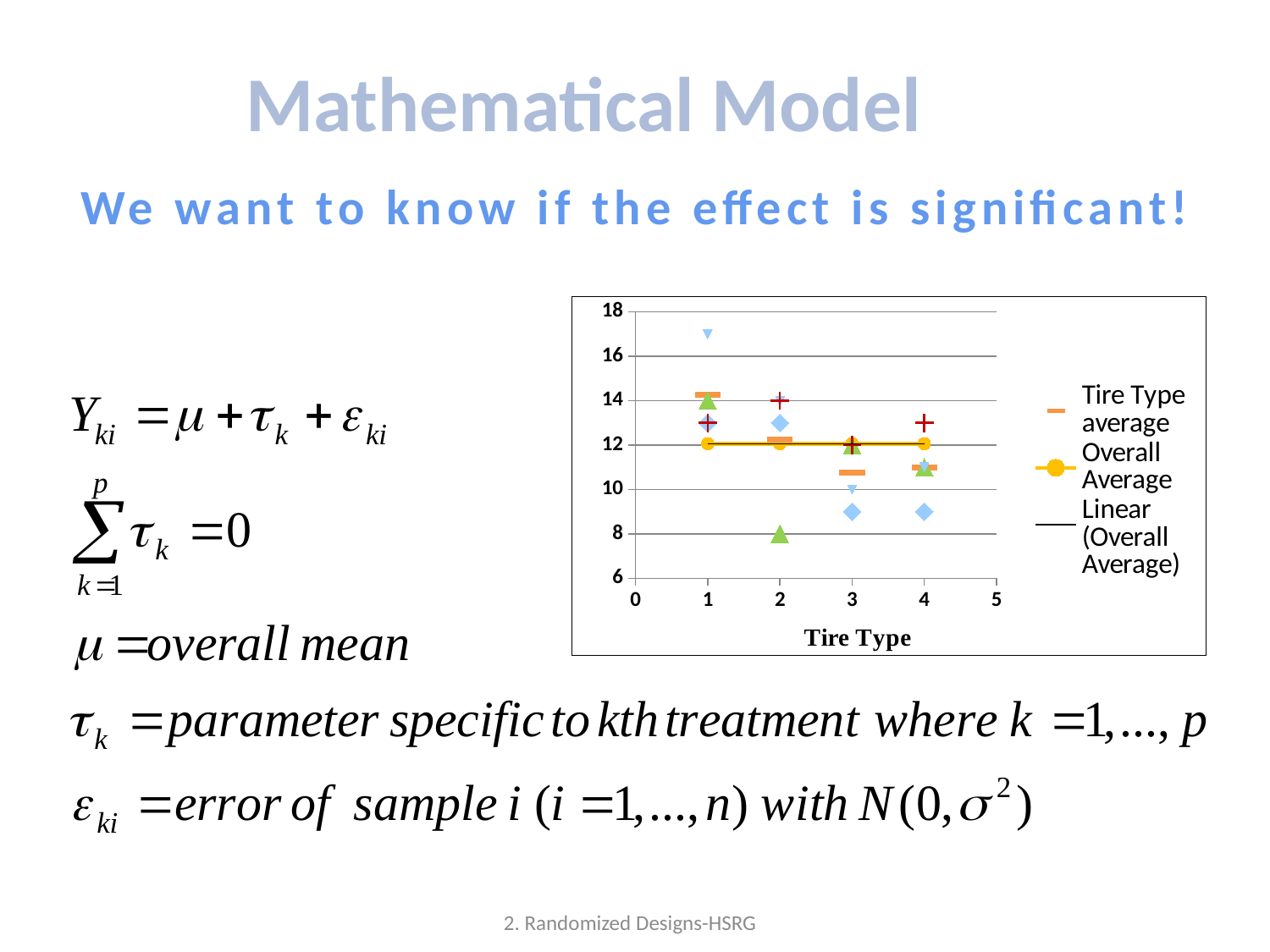
Is the Tire Type average for tire type 1 greater or less than 12? greater Is the highest plotted point for tire type 1 greater or less than 16? greater Is the Tire Type average for tire type 4 greater or less than 12? less What is the maximum value shown on the y axis? 18 Which tire type has the highest Tire Type average? 1 What kind of chart is shown on the slide? scatter chart What is the title of the x axis of the chart? Tire Type How many tire types have a Tire Type average plotted? 4 Which is larger, the Tire Type average for tire type 1 or for tire type 3? tire type 1 How many series does the chart legend list? 3